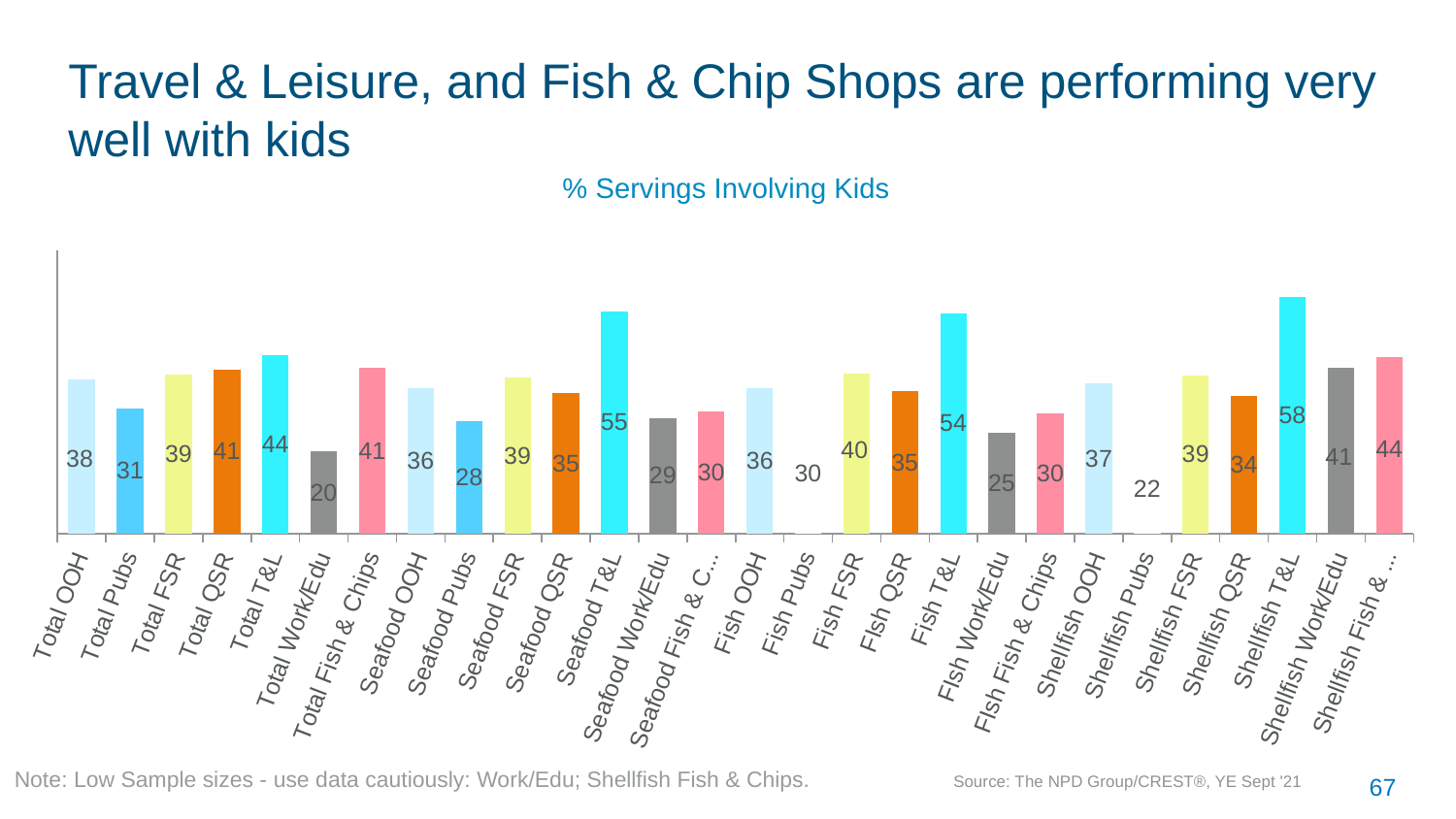
What kind of chart is shown on the slide? Bar chart What is the difference between the values for Fish T&L and Fish Pubs? 24 How many categories are shown on the x axis? 28 Which category has the lowest value? Total Work/Edu What is the value for Seafood T&L? 55 What is the difference between the values for Shellfish T&L and Total Work/Edu? 38 Which category has the highest value? Shellfish T&L What is the value for Fish Work/Edu? 25 What is the title of the chart? % Servings Involving Kids Which is larger, the value for Total QSR or the value for Seafood QSR? Total QSR What is the value for Shellfish Pubs? 22 What is the value for Total T&L? 44